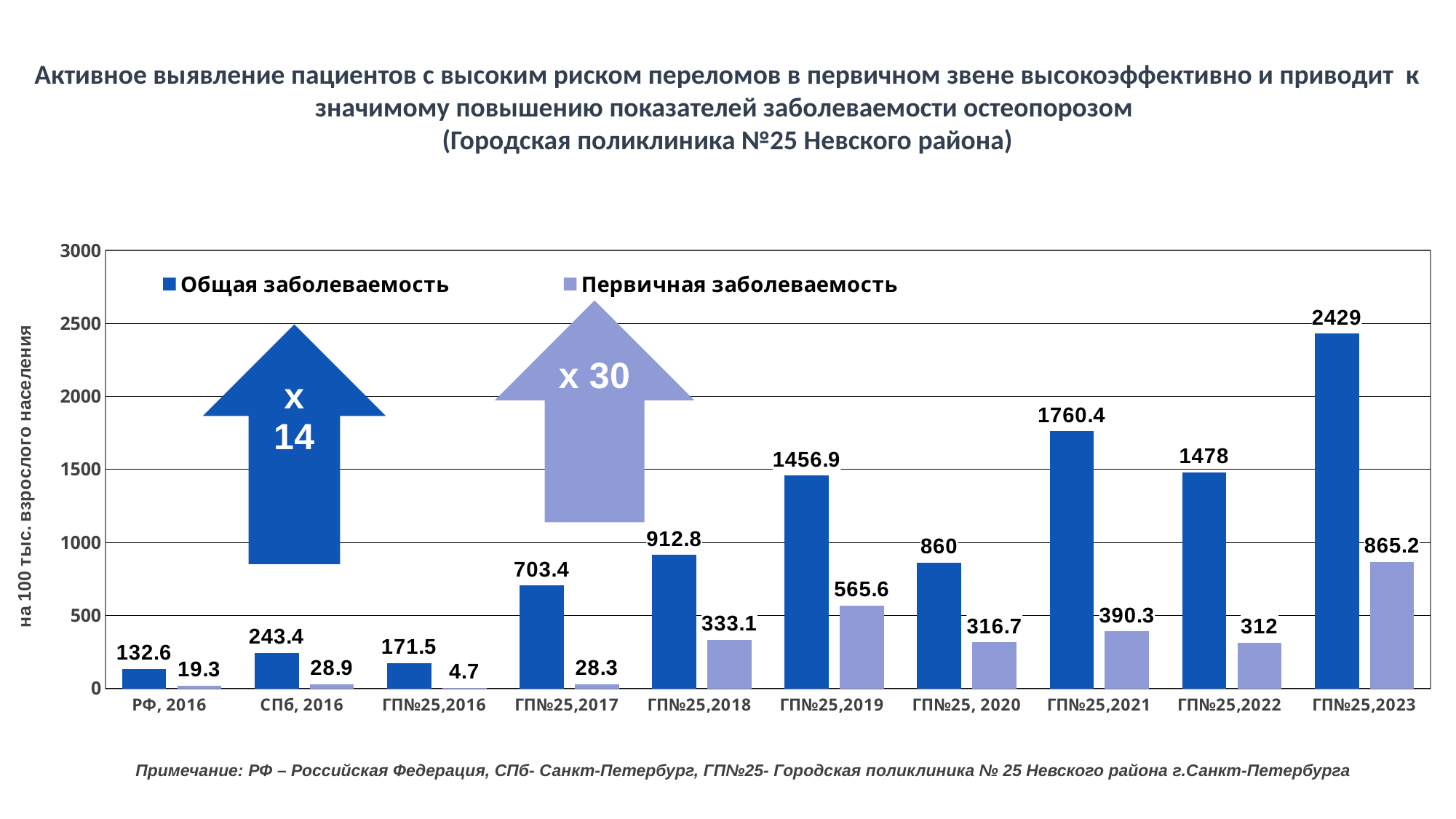
Is the value of Общая заболеваемость for ГП№25,2019 greater or less than 1500? less How many categories are shown on the x axis of the chart? 10 What is the label of the vertical axis of the chart? на 100 тыс. взрослого населения How many series does the chart legend list? 2 Which category has the lowest value of Первичная заболеваемость? ГП№25,2016 What is the value of Первичная заболеваемость for ГП№25,2019? 565.6 What is the value of Общая заболеваемость for ГП№25,2023? 2429 What is the difference between Общая заболеваемость for ГП№25,2021 and ГП№25,2022? 282.4 What type of chart is shown on the slide? bar chart Which is larger: Первичная заболеваемость for ГП№25,2018 or for ГП№25,2020? ГП№25,2018 What is the value of Первичная заболеваемость for ГП№25,2016? 4.7 Which category has the highest value of Общая заболеваемость? ГП№25,2023